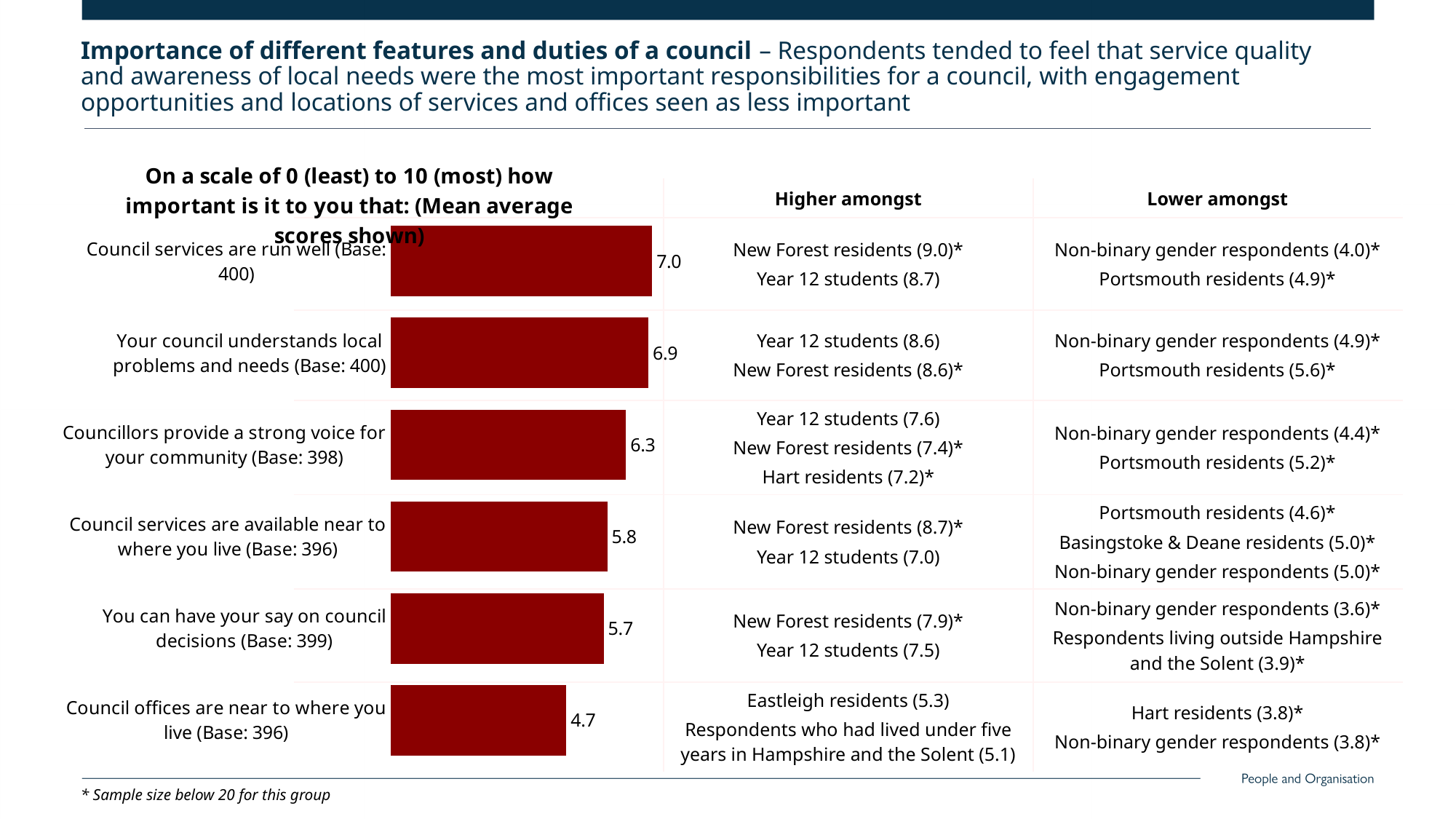
How many features are shown as bars in the chart? 6 What is the mean importance score for 'Your council understands local problems and needs'? 6.9 What is the difference between the mean scores for 'Council services are run well' and 'Council offices are near to where you live'? 2.3 What type of chart is used to show the mean importance scores? Bar chart Which feature has the highest mean importance score? Council services are run well What is the base (number of respondents) for 'Councillors provide a strong voice for your community'? 398 What is the mean importance score for 'You can have your say on council decisions'? 5.7 What is the mean importance score for 'Council services are run well'? 7.0 Which feature has the lowest mean importance score? Council offices are near to where you live What is the mean importance score for 'Council offices are near to where you live'? 4.7 Which has a higher mean score: 'Councillors provide a strong voice for your community' or 'Council services are available near to where you live'? Councillors provide a strong voice for your community What colour are the bars in the chart? Dark red